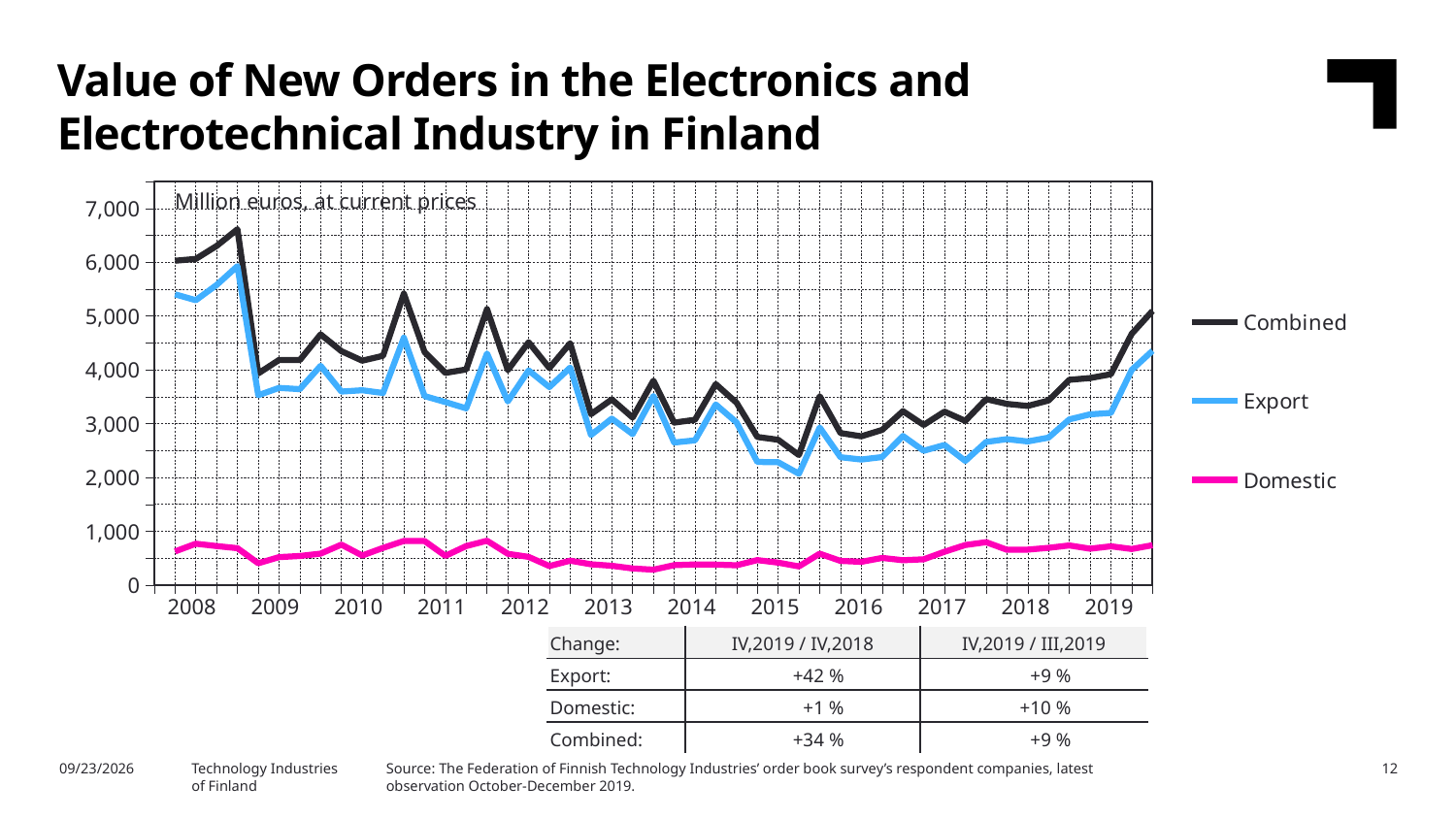
How many series does the chart legend list? 3 Which series is plotted with the pink line? Domestic Is the value of the Domestic series at any point greater or less than 1,000? less Does the Combined series rise or fall between 2016 and 2019? rise Is the peak value of the Combined series in 2008 greater or less than 6,000? greater Which series has the lowest values throughout the chart? Domestic What unit is stated for the values in the chart? Million euros, at current prices Does the Combined series rise or fall between 2008 and 2015? fall Is the value of the Export series at the end of 2019 greater or less than 4,000? greater Which series has the highest values throughout the chart? Combined What kind of chart is shown on the slide? line chart According to the table below the chart, what is the Export change for IV,2019 / IV,2018? +42 %